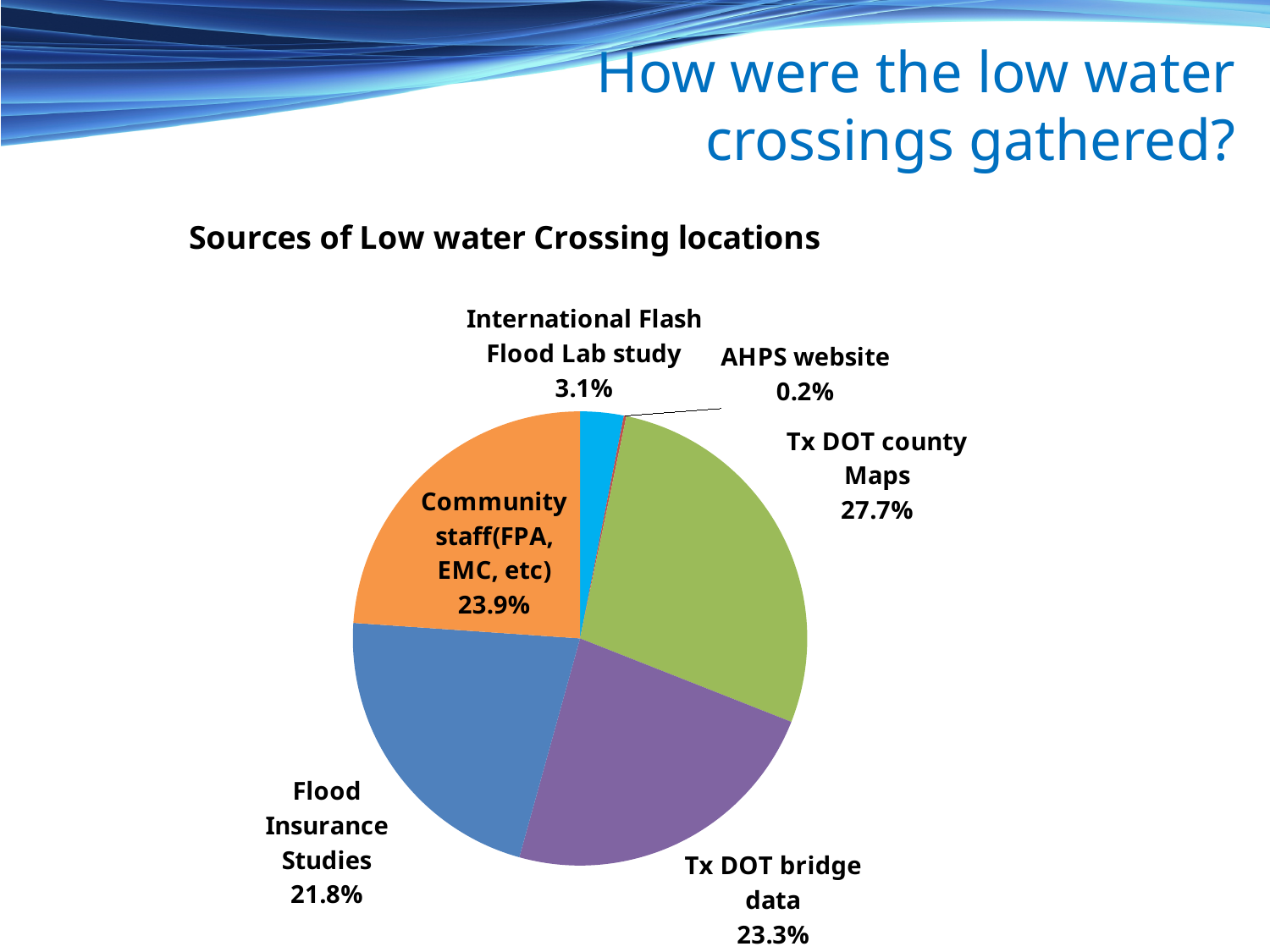
Which is larger: the share for Community staff(FPA, EMC, etc) or the share for Tx DOT bridge data? Community staff(FPA, EMC, etc) What is the difference in percentage points between Tx DOT county Maps and Flood Insurance Studies? 5.9 Which source accounts for the largest share of low water crossing locations? Tx DOT county Maps What percentage of the pie is attributed to Flood Insurance Studies? 21.8% What type of chart is shown on the slide? Pie chart What is the title of the chart? Sources of Low water Crossing locations Which source accounts for the smallest share of low water crossing locations? AHPS website How many slices does the pie chart have? 6 What is the share for the AHPS website slice? 0.2% What percentage is shown for the International Flash Flood Lab study? 3.1% What share of low water crossing locations came from Tx DOT county Maps? 27.7% What is the combined share of Tx DOT county Maps and Tx DOT bridge data? 51.0%